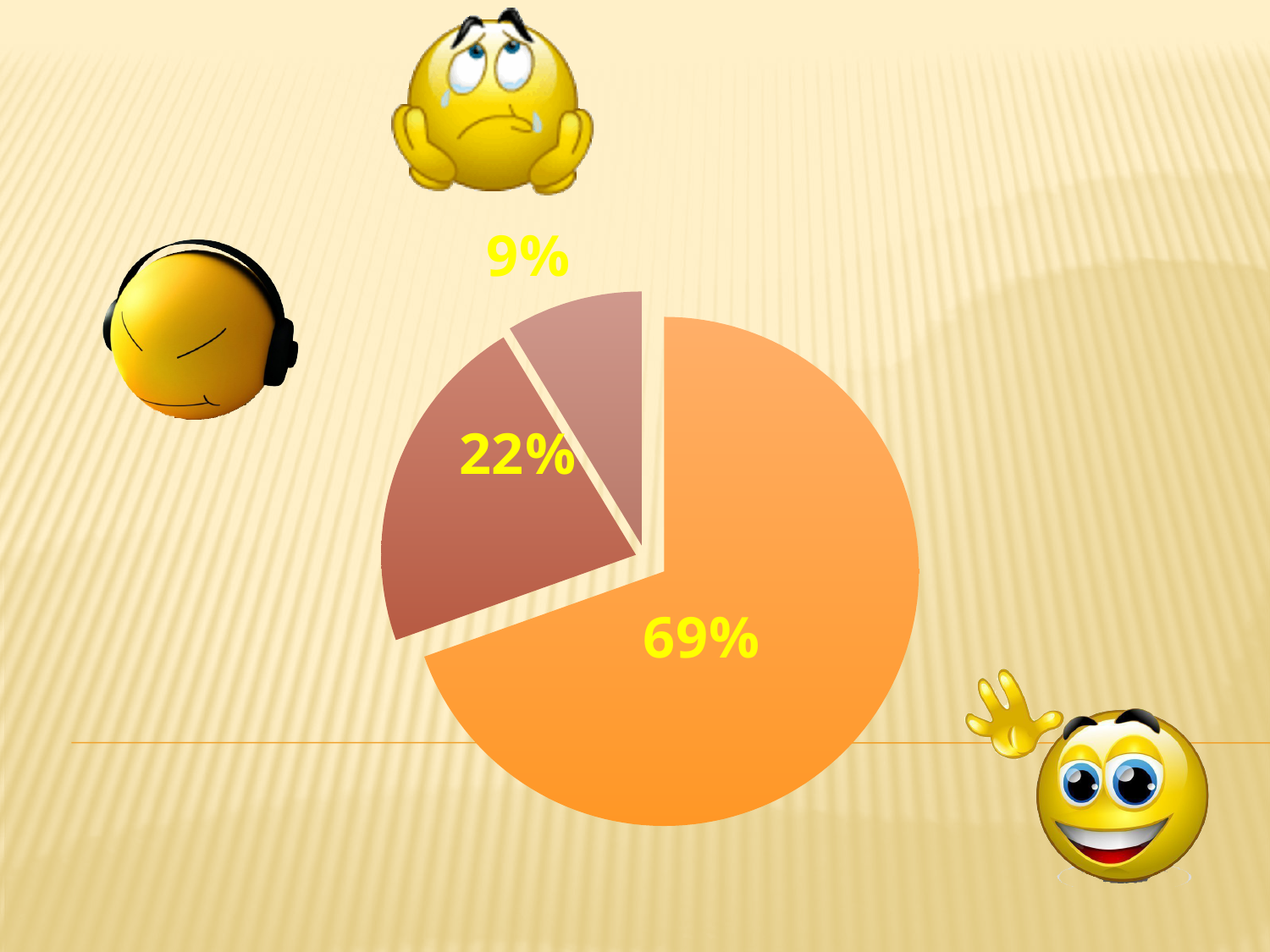
What percentage is shown on the dark red slice of the pie chart? 22% What colour is the largest slice of the pie chart? orange Is the value of the orange slice greater or less than 50%? greater What percentage is shown on the small slice at the top of the pie chart? 9% Which is larger, the orange slice or the dark red slice? the orange slice What is the value shown on the largest slice of the pie chart? 69% What kind of chart is shown on the slide? pie chart What percentage is shown on the orange slice of the pie chart? 69% How many slices does the pie chart have? 3 What is the difference between the 69% slice and the 22% slice? 47% What is the value shown on the smallest slice of the pie chart? 9% What is the difference between the 22% slice and the 9% slice? 13%